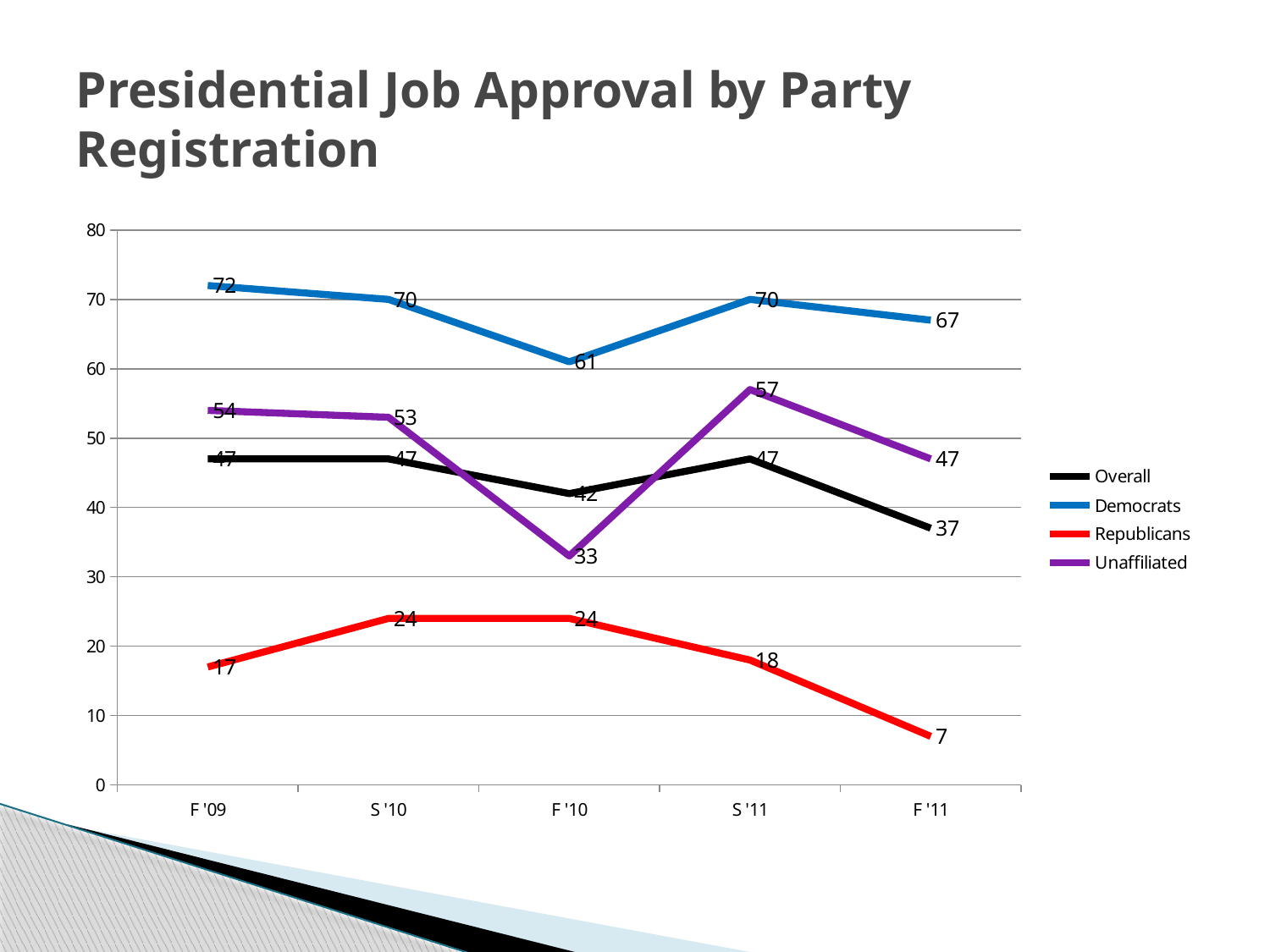
At which x-axis point is the Democrats series highest? F '09 How many series does the legend list? 4 How many x-axis points are plotted for each series? 5 What is the Democrats value at F '10? 61 Which is larger at S '10: the Unaffiliated value or the Overall value? Unaffiliated What kind of chart is shown on the slide? Line chart What is the Unaffiliated value at S '11? 57 What is the Overall value at F '11? 37 What is the difference between the Democrats and Republicans values at F '11? 60 Does the Republicans series rise or fall from S '11 to F '11? Fall At which x-axis point is the Unaffiliated series lowest? F '10 What is the Republicans value at F '11? 7